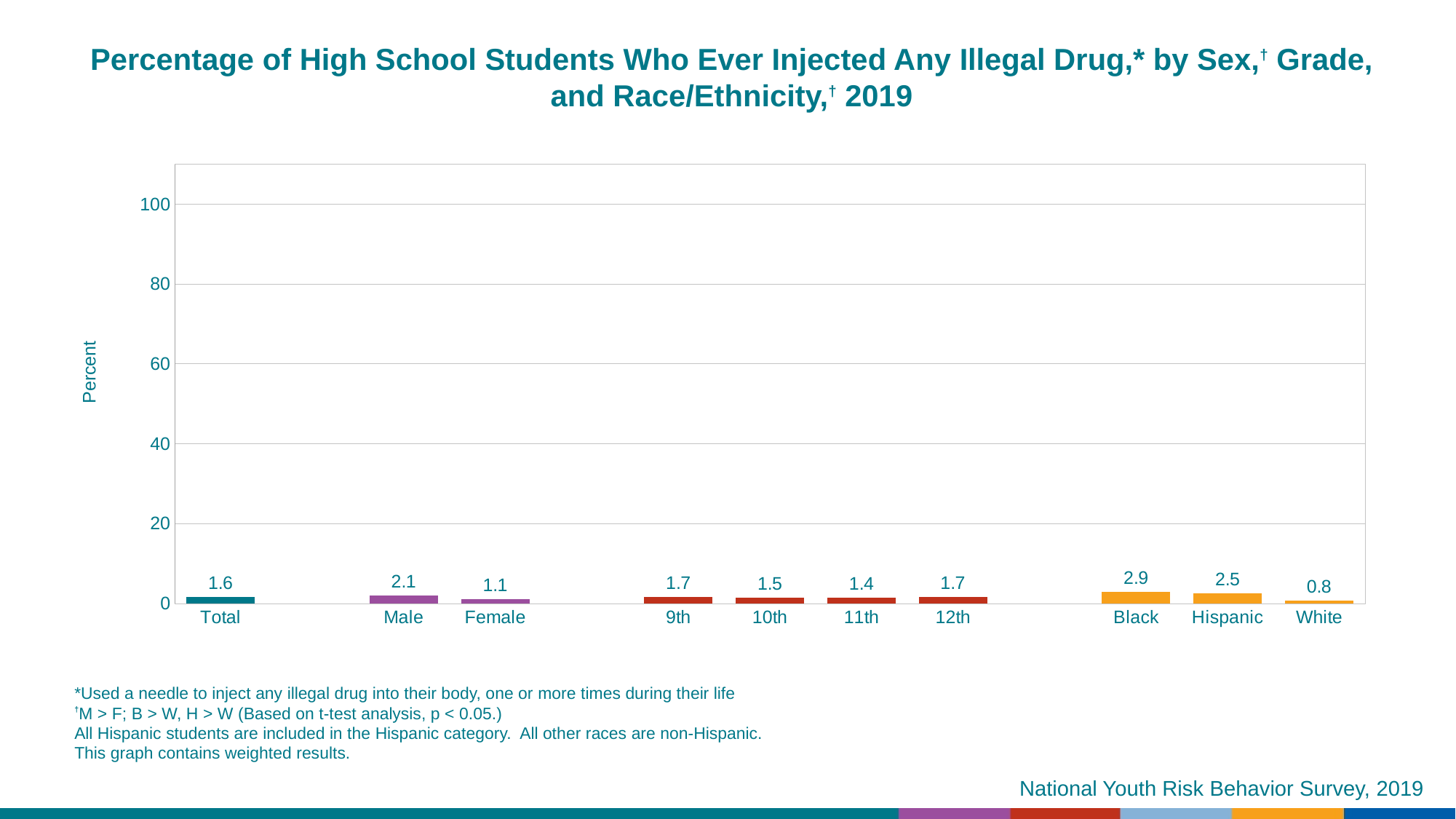
How many categories are shown on the x axis? 10 Which is larger, the value for Hispanic or the value for White? Hispanic What kind of chart is this? Bar chart Which category has the lowest value? White What is the value for Male? 2.1 What is the label of the y axis? Percent Which category has the highest value? Black What is the value for Total? 1.6 What is the difference between the values for Male and Female? 1.0 What is the value for Black? 2.9 What is the value for White? 0.8 What is the difference between the values for Black and White? 2.1